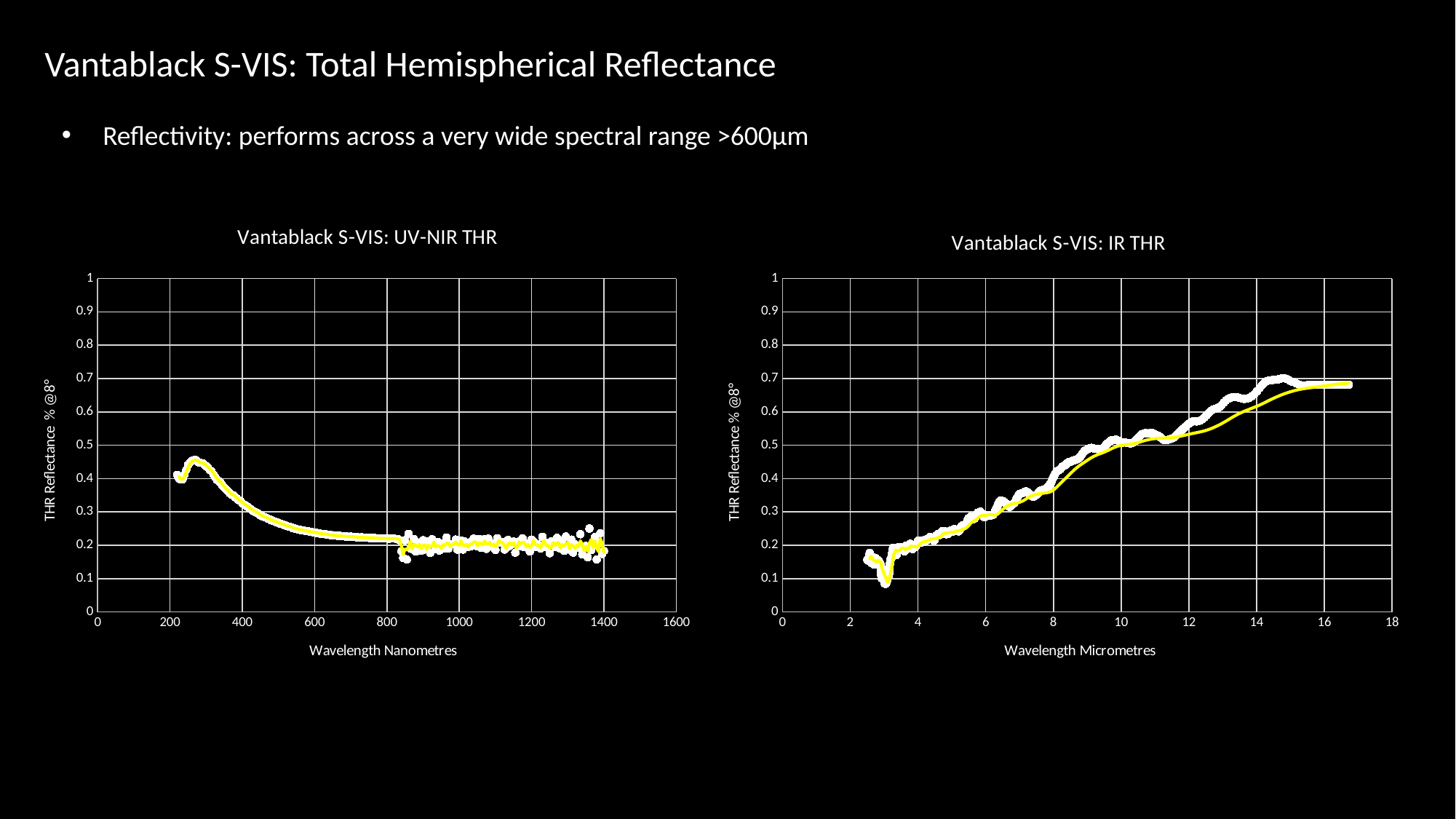
What is the title of the chart on the left of the slide? Vantablack S-VIS: UV-NIR THR In the 'Vantablack S-VIS: UV-NIR THR' chart, is the peak reflectance near 270 nanometres greater or less than 0.5? less In the 'Vantablack S-VIS: IR THR' chart, is the reflectance at 16 micrometres greater or less than 0.6? greater In the 'Vantablack S-VIS: IR THR' chart, is the reflectance at 10 micrometres greater or less than 0.4? greater In the 'Vantablack S-VIS: UV-NIR THR' chart on the left, do the reflectance values rise or fall between 400 and 1400 nanometres? fall What is the x-axis label of the 'Vantablack S-VIS: IR THR' chart on the right? Wavelength Micrometres In the 'Vantablack S-VIS: IR THR' chart, is the reflectance larger at 4 micrometres or at 16 micrometres? 16 micrometres In the 'Vantablack S-VIS: UV-NIR THR' chart, is the reflectance larger at 300 nanometres or at 1200 nanometres? 300 nanometres In the 'Vantablack S-VIS: IR THR' chart on the right, do the reflectance values generally rise or fall as wavelength increases? rise What kind of chart is the 'Vantablack S-VIS: UV-NIR THR' chart on the left? line chart